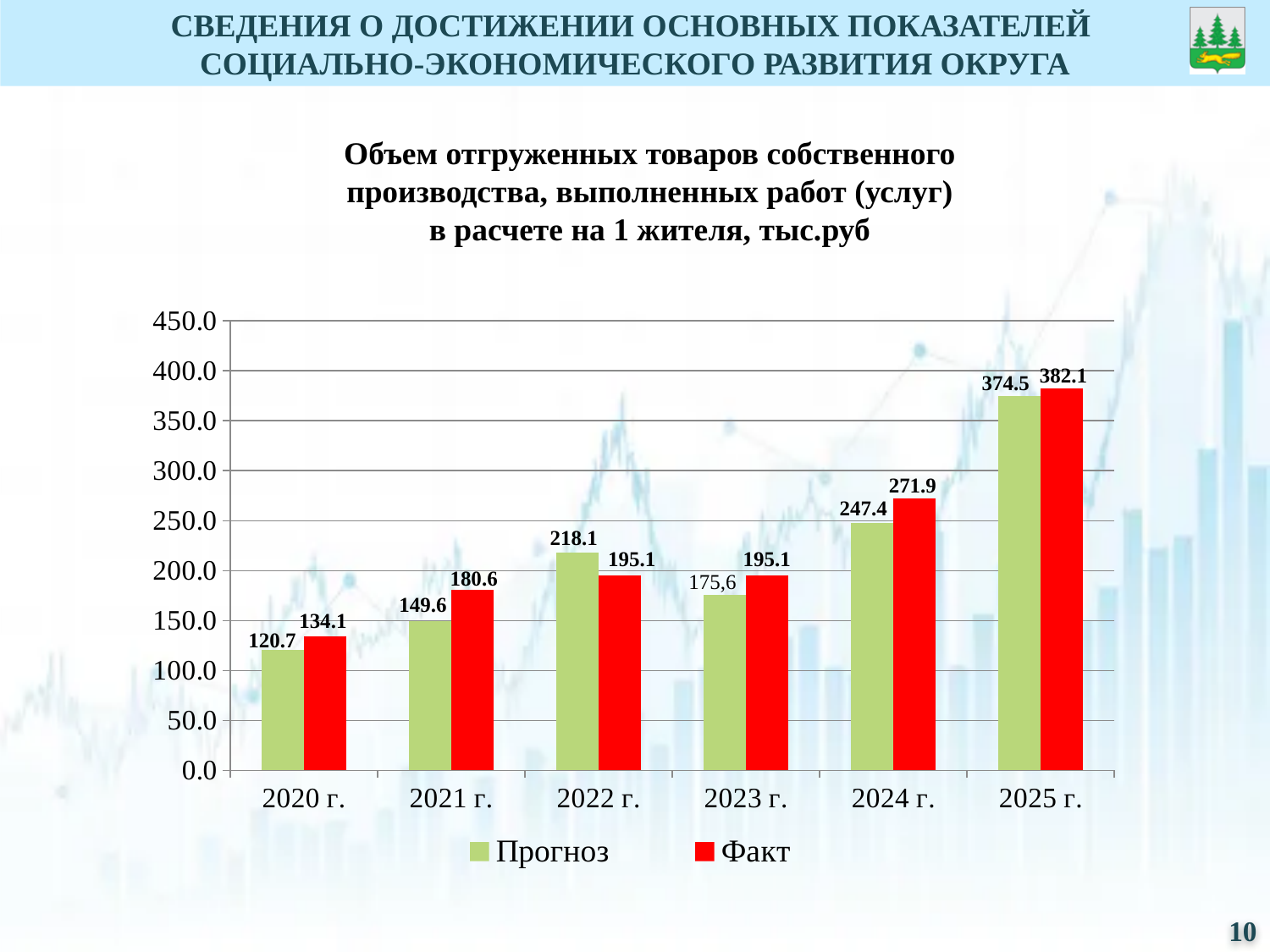
Which year has the lowest Прогноз value? 2020 г. What is the difference between the Факт and Прогноз values for 2025 г.? 7.6 How many years are shown on the x axis? 6 What kind of chart is shown on the slide? bar chart What is the Прогноз value for 2024 г.? 247.4 How many series does the legend list? 2 What is the Прогноз value for 2023 г.? 175,6 What is the difference between the Прогноз and Факт values for 2022 г.? 23.0 Which year has the highest Факт value? 2025 г. For 2022 г., which is larger: Прогноз or Факт? Прогноз Is the Факт value for 2024 г. greater or less than 250.0? greater What is the Факт value for 2021 г.? 180.6